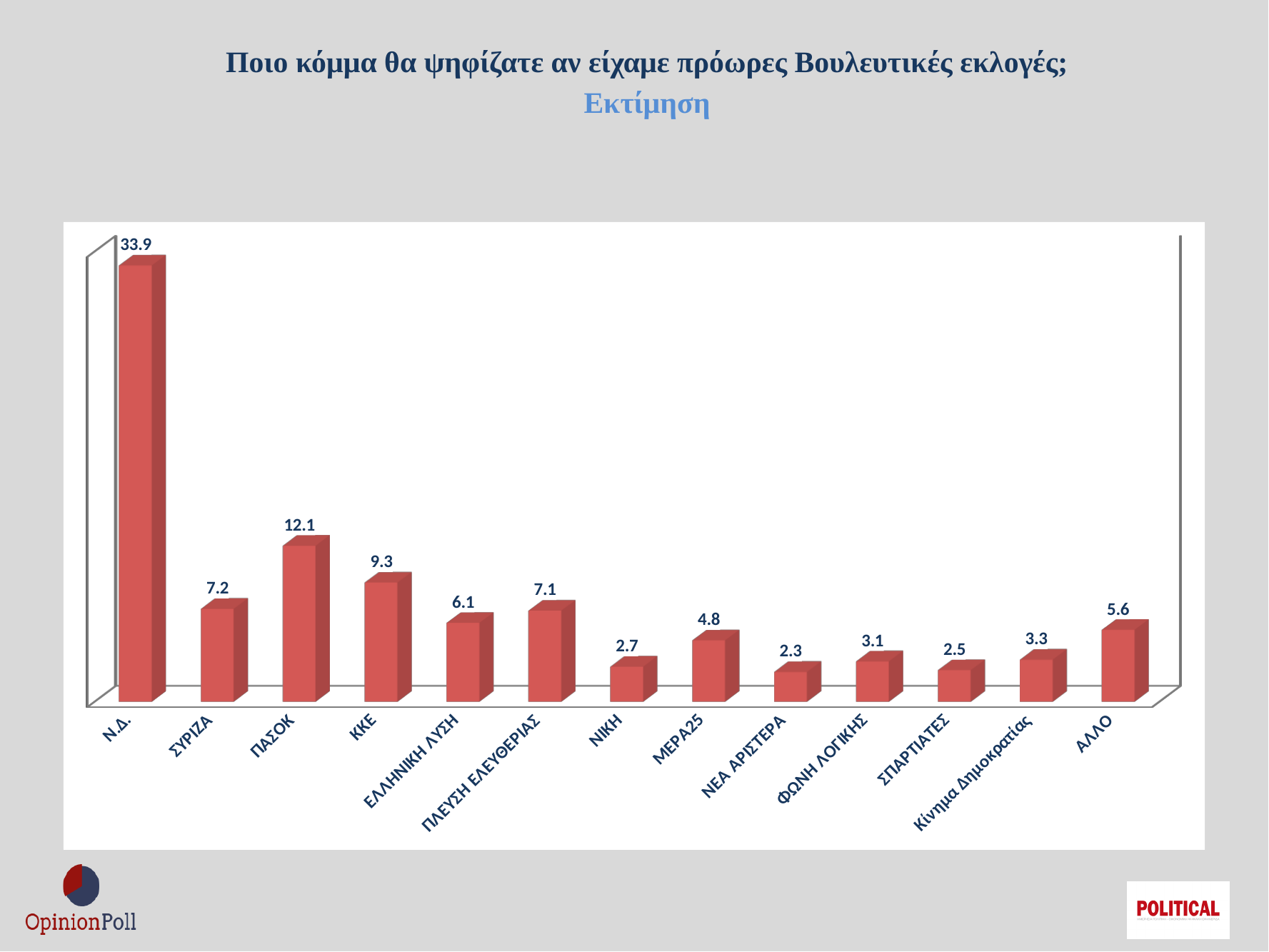
What kind of chart is shown on the slide? Bar chart Which has a larger value, ΚΚΕ or ΕΛΛΗΝΙΚΗ ΛΥΣΗ? ΚΚΕ What is the value for Κίνημα Δημοκρατίας? 3.3 What is the value for ΠΛΕΥΣΗ ΕΛΕΥΘΕΡΙΑΣ? 7.1 What is the difference between the values for ΠΑΣΟΚ and ΣΥΡΙΖΑ? 4.9 What is the difference between the values for Ν.Δ. and ΠΑΣΟΚ? 21.8 How many categories are shown on the x axis? 13 What is the value for ΠΑΣΟΚ? 12.1 What is the value for Ν.Δ.? 33.9 Which category has the lowest value? ΝΕΑ ΑΡΙΣΤΕΡΑ What is the subtitle shown below the chart title? Εκτίμηση Which party has the highest value? Ν.Δ.